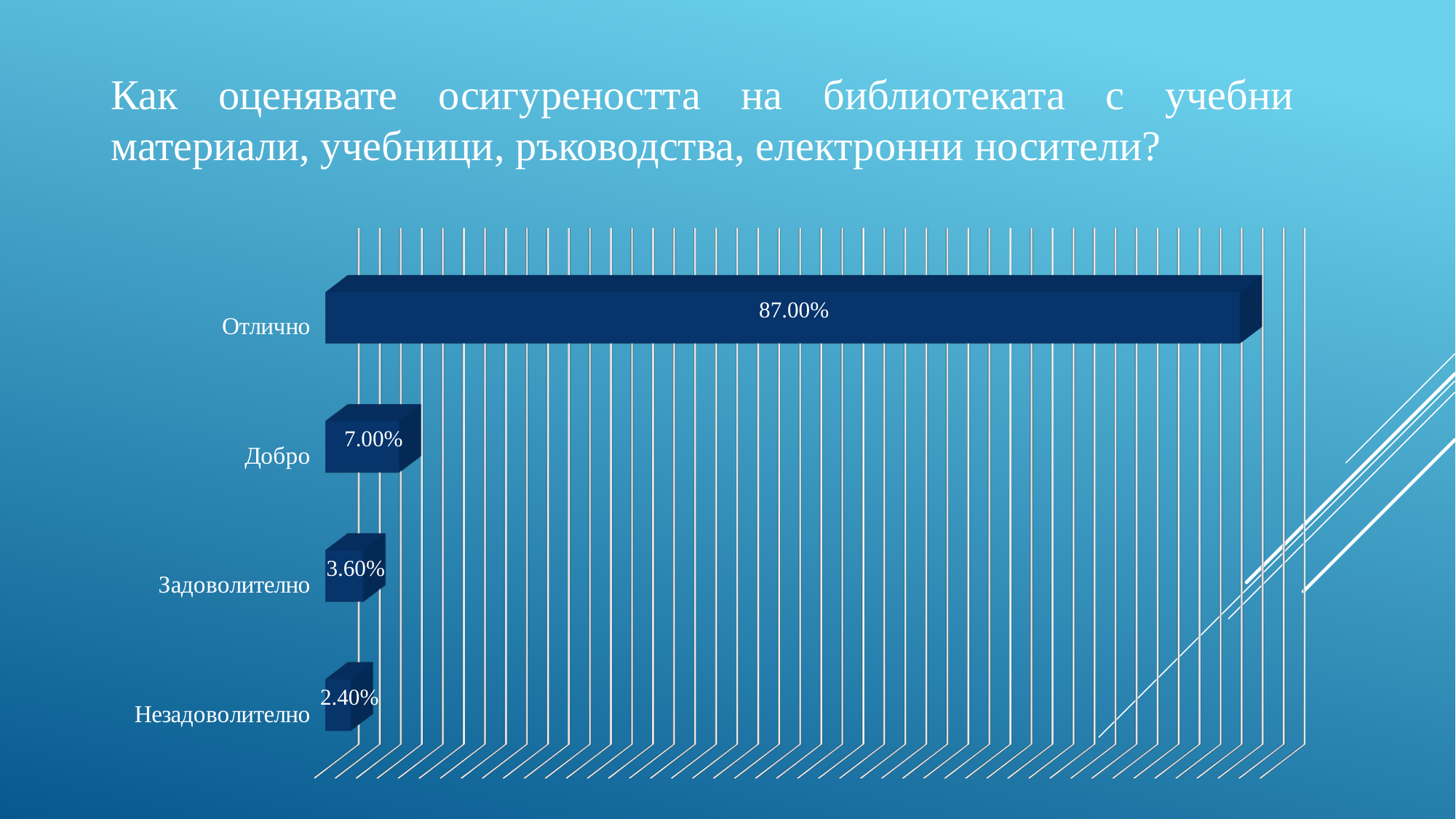
What is the difference between the values for Отлично and Добро? 80.00% What is the total of all four values shown in the chart? 100.00% How many categories are shown in the chart? 4 What is the value for Незадоволително? 2.40% Which category has the highest value? Отлично Which is larger, the value for Добро or the value for Задоволително? Добро Which category has the lowest value? Незадоволително What is the value for Отлично? 87.00% What is the value for Добро? 7.00% What kind of chart is shown on the slide? Bar chart What is the difference between the values for Задоволително and Незадоволително? 1.20% What is the value for Задоволително? 3.60%